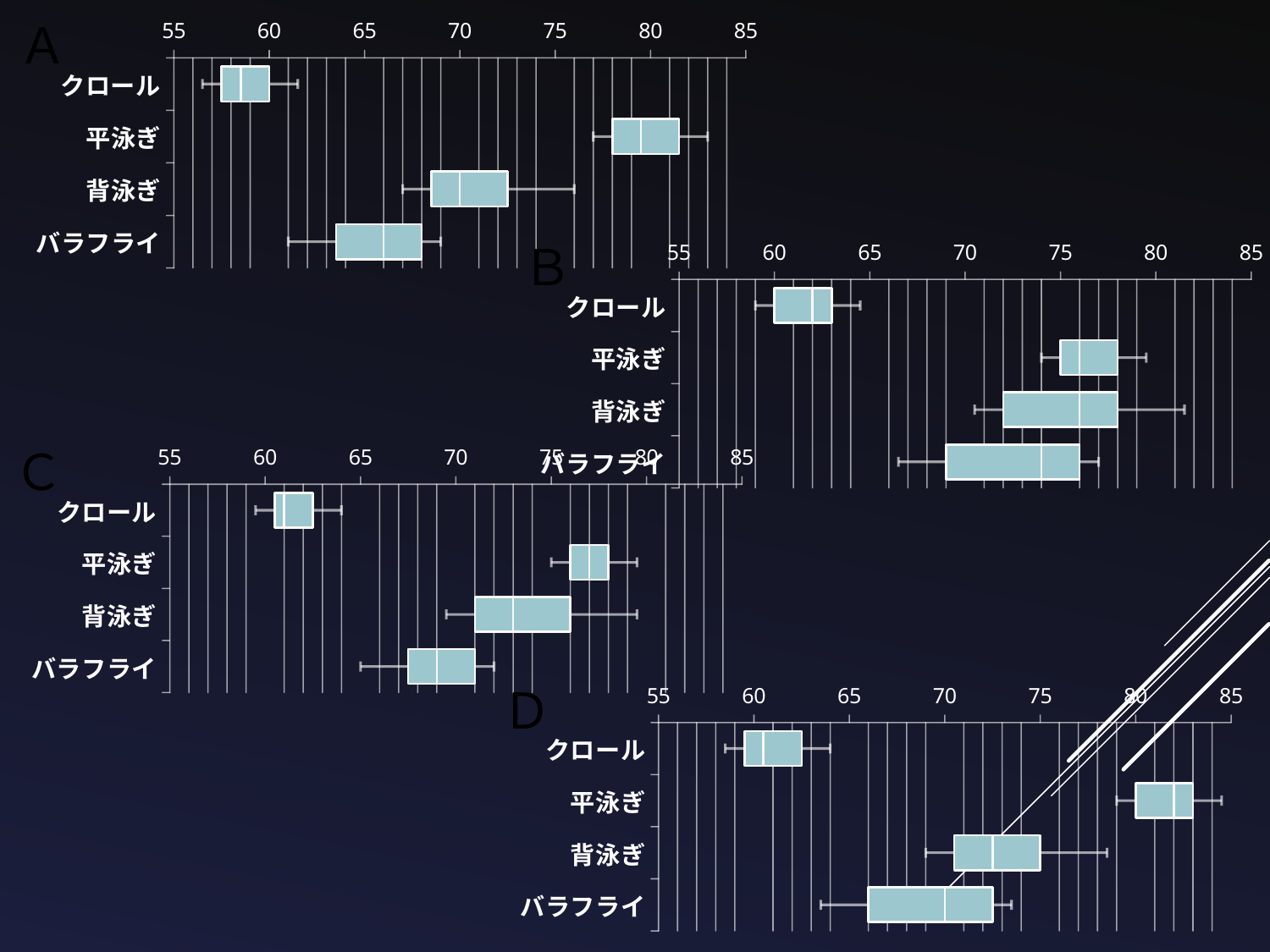
In chart A, is the median for クロール greater or less than 60? less What kind of chart is chart A? Box plot What is the range of the horizontal axis in chart C? 55 to 85 In chart A, which category has the lowest median? クロール In chart D, which category has the lowest median? クロール In chart A, which has the higher median, 背泳ぎ or バラフライ? 背泳ぎ In chart D, is the median for 平泳ぎ greater or less than 80? greater In chart A, which category has the highest median? 平泳ぎ In chart C, is the median for バラフライ greater or less than 70? less How many categories does chart A show? 4 In chart B, which has the higher median, 背泳ぎ or バラフライ? 背泳ぎ How many separate charts are shown on the slide? 4